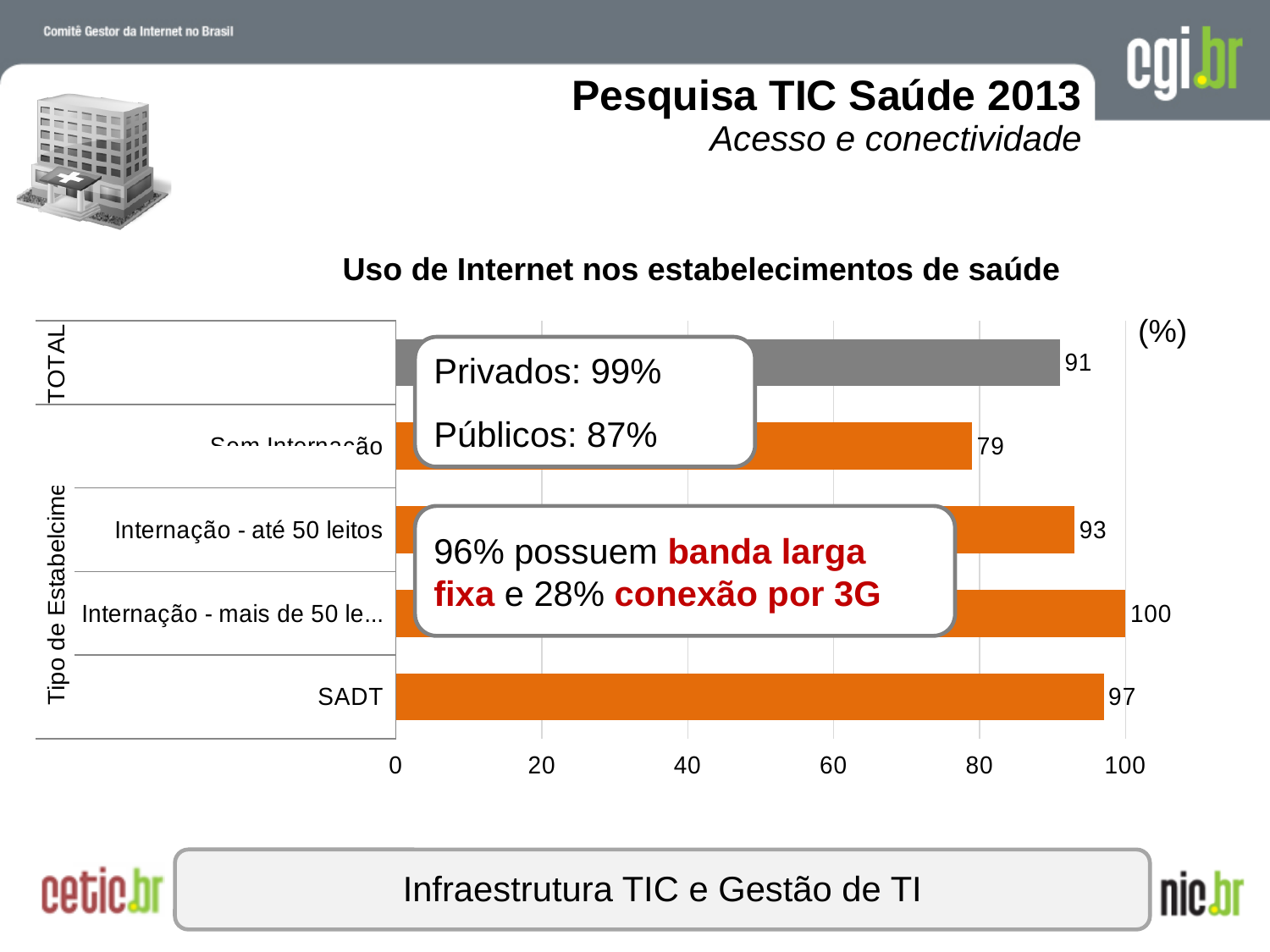
What is the value for TOTAL in the chart? 91 What is the difference between the values for SADT and 'Sem Internação'? 18 What kind of chart is shown on the slide? Bar chart Which category has the lowest value in the chart? Sem Internação What is the value for the category labelled 'Internação - mais de 50 le...'? 100 What is the title of the chart on the slide? Uso de Internet nos estabelecimentos de saúde What is the value for 'Internação - até 50 leitos'? 93 Which is larger, the value for SADT or the value for 'Internação - até 50 leitos'? SADT What is the value for SADT in the chart 'Uso de Internet nos estabelecimentos de saúde'? 97 How many categories (bars) are shown in the chart? 5 What is the value for 'Sem Internação'? 79 Which category has the highest value in the chart? Internação - mais de 50 le...